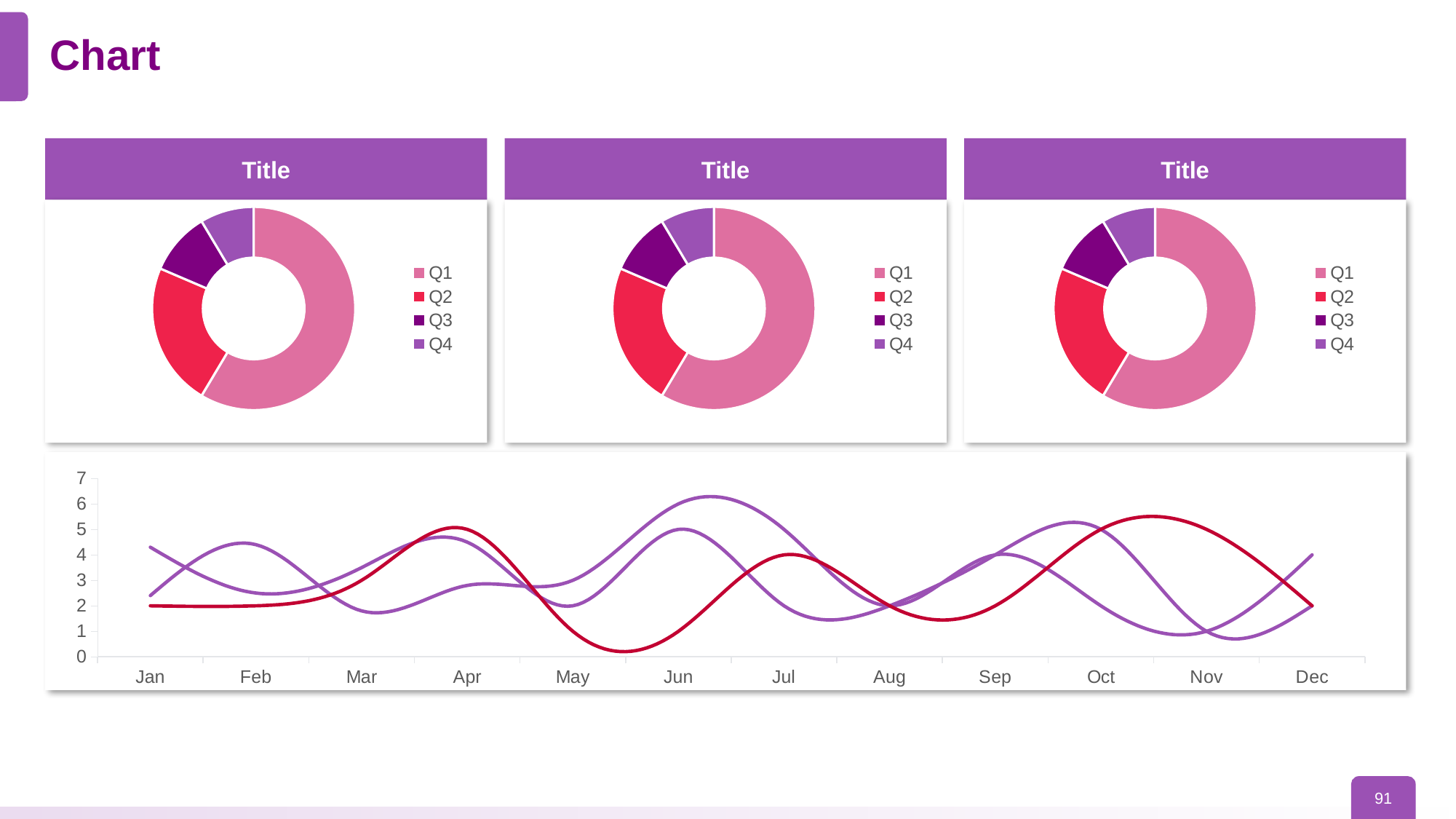
In the bottom line chart, how many lines are plotted? 3 In the left-hand donut chart, how many entries does the legend list? 4 How many charts are shown on the slide? 4 In the bottom line chart, how many months are shown on the x axis? 12 In the middle donut chart, which quarter has the largest slice? Q1 What kind of chart is the chart at the bottom of the slide? Line chart What kind of chart is the left-hand chart titled "Title"? Donut chart In the bottom line chart, is the value of the red line at Apr greater or less than 4? greater In the right-hand donut chart, which slice is larger, Q2 or Q3? Q2 In the bottom line chart, is the value of the red line at Nov greater or less than 4? greater In the left-hand donut chart, which slice is larger, Q1 or Q2? Q1